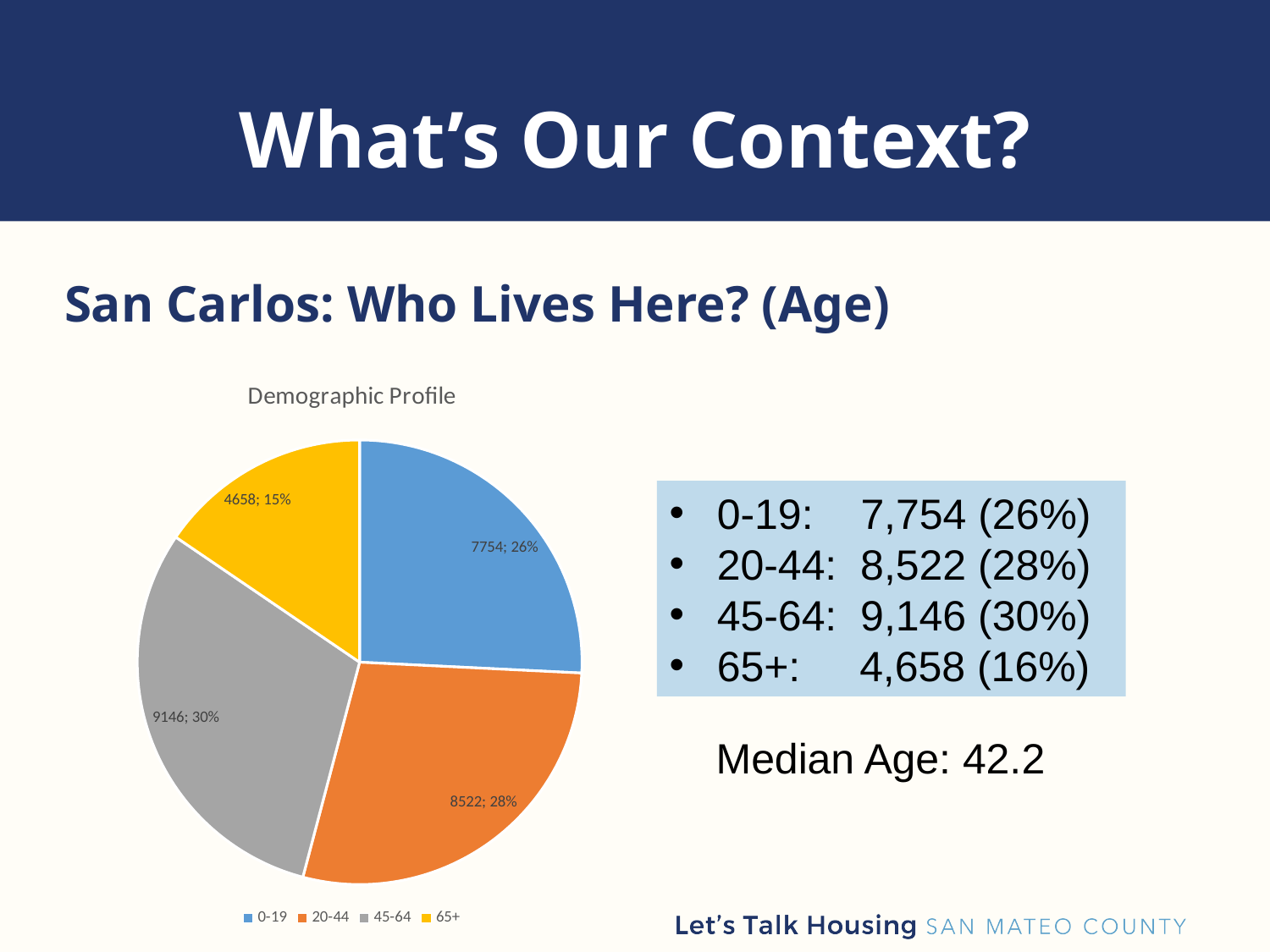
What value is shown for the 45-64 slice of the pie chart? 9146 What type of chart is shown on the slide? pie chart Which age group has the largest slice in the pie chart? 45-64 Which is larger, the value for 20-44 or the value for 0-19? 20-44 What value is shown for the 65+ slice of the pie chart? 4658 How many slices does the pie chart have? 4 What is the title of the chart? Demographic Profile What is the difference between the values for the 45-64 and 65+ slices? 4488 What value is shown for the 0-19 slice of the pie chart? 7754 What percentage share of the pie does the 65+ slice represent? 15% Which age group has the smallest slice in the pie chart? 65+ What percentage share of the pie does the 20-44 slice represent? 28%